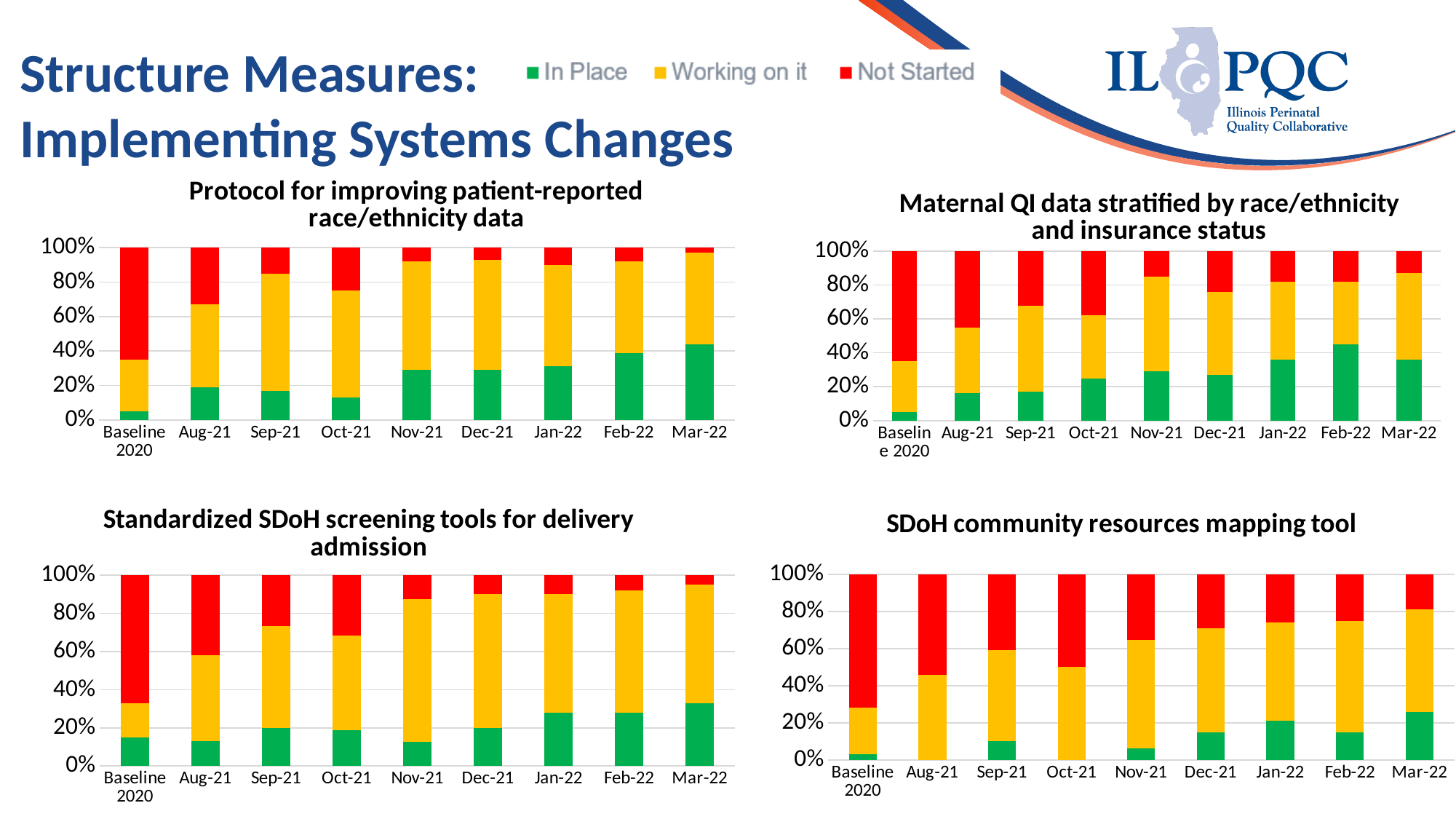
What kind of chart is the "Protocol for improving patient-reported race/ethnicity data" chart? Stacked bar chart In the "Standardized SDoH screening tools for delivery admission" chart, which period has the largest In Place segment? Mar-22 In the "Standardized SDoH screening tools for delivery admission" chart, is the In Place share for Mar-22 greater or less than 20%? greater In the "Protocol for improving patient-reported race/ethnicity data" chart, is the In Place share for Baseline 2020 greater or less than 20%? less In the "SDoH community resources mapping tool" chart, is the Not Started share for Baseline 2020 greater or less than 60%? greater In the "Protocol for improving patient-reported race/ethnicity data" chart, which period has the largest Not Started segment? Baseline 2020 In the "SDoH community resources mapping tool" chart, which period has the smallest In Place segment? Aug-21 and Oct-21 (no In Place segment, 0%) In the "Maternal QI data stratified by race/ethnicity and insurance status" chart, which period has the largest In Place segment? Feb-22 How many series does the shared legend at the top of the slide list? 3 How many time periods are shown on the x axis of the "SDoH community resources mapping tool" chart? 9 In the "Protocol for improving patient-reported race/ethnicity data" chart, does the Not Started share generally rise or fall from Baseline 2020 to Mar-22? fall